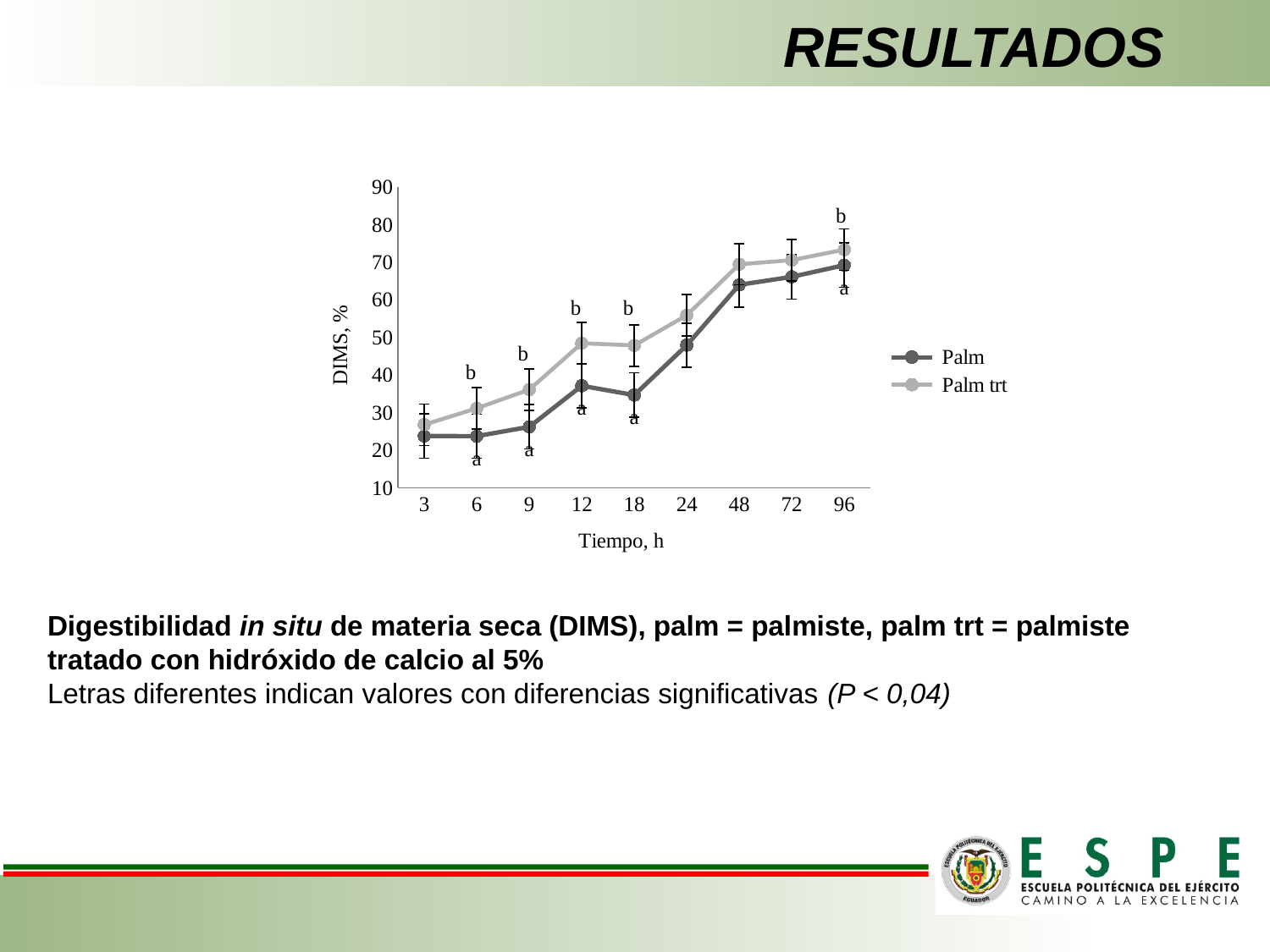
At which time does the Palm trt series reach its highest DIMS value? 96 How many time points are plotted along the x axis? 9 Is the value for Palm trt at 12 h greater or less than 40? greater Is the value for Palm at 48 h greater or less than 60? greater What kind of chart is shown on the slide? line chart Is the value for Palm at 3 h greater or less than 30? less At 9 h, which series has the higher DIMS value, Palm or Palm trt? Palm trt How many series does the legend list? 2 Do the DIMS values for Palm trt generally rise or fall as time increases? rise What is the label of the y axis? DIMS, % At which time does the Palm trt series have its lowest DIMS value? 3 At 12 h, which series has the higher DIMS value, Palm or Palm trt? Palm trt